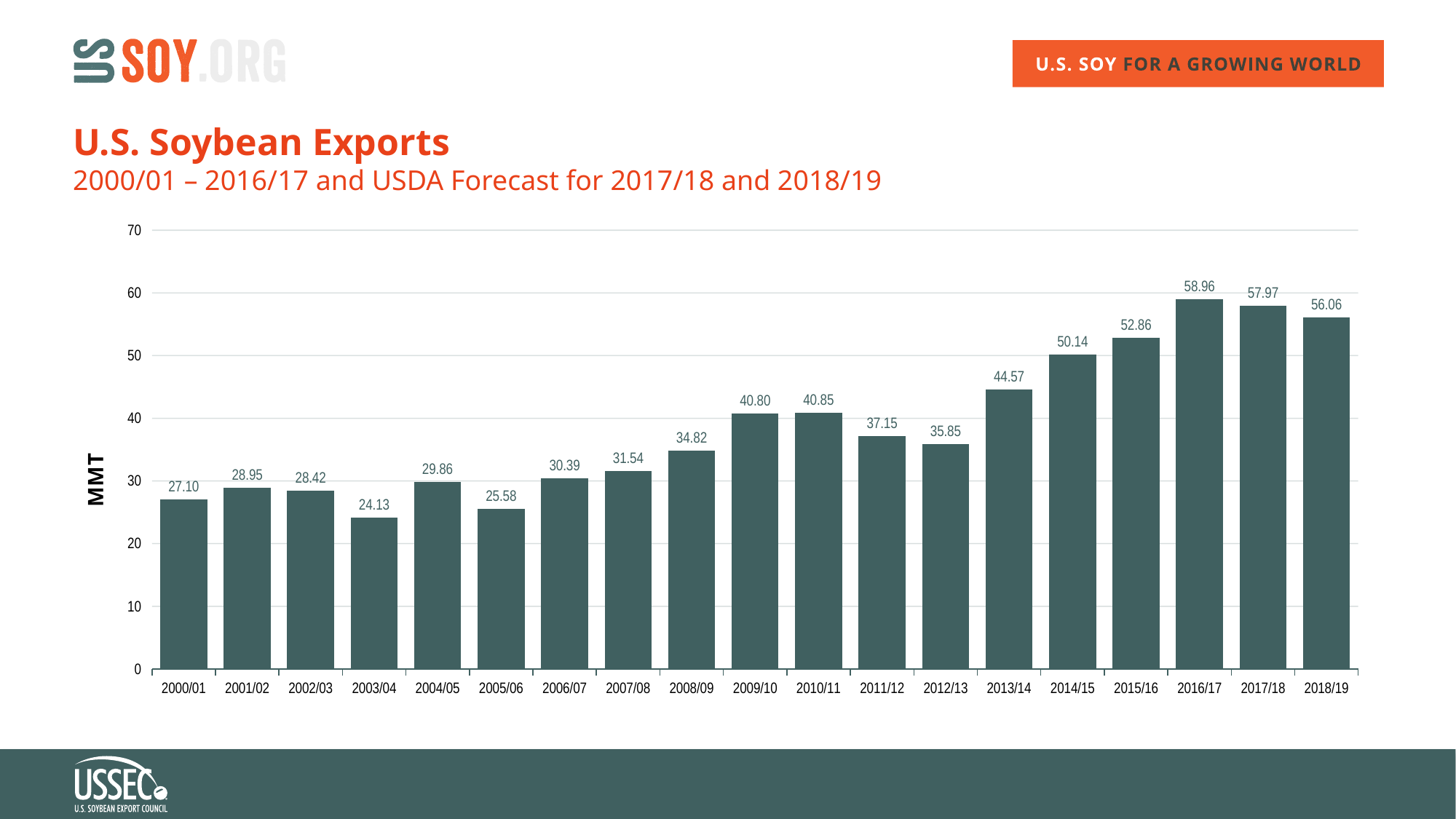
Is the value for 2014/15 greater or less than 40? greater What is the value for 2003/04? 24.13 Which year has the highest value? 2016/17 Which is larger, the value for 2011/12 or the value for 2012/13? 2011/12 Do the values generally rise or fall from 2003/04 to 2016/17? rise What kind of chart is this? bar chart Which year has the lowest value? 2003/04 What is the label on the y axis? MMT What is the value for 2016/17? 58.96 What is the value for 2009/10? 40.80 What is the difference between the values for 2016/17 and 2000/01? 31.86 How many years are shown on the x axis? 19